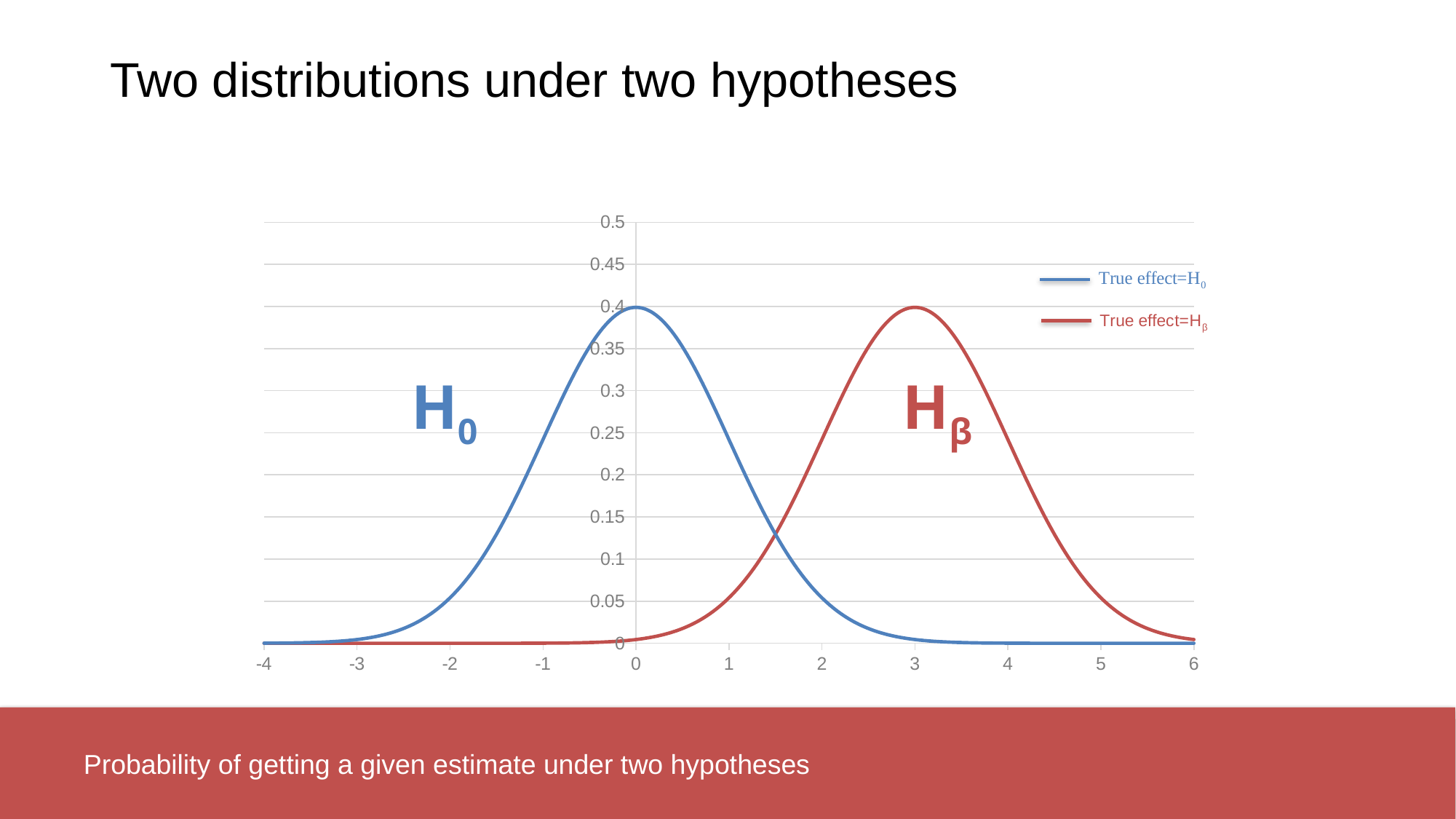
At x = 1, which curve is higher, the blue H0 curve or the red Hβ curve? blue H0 curve How many series does the chart's legend list? 2 At x = 2, which curve is higher, the blue H0 curve or the red Hβ curve? red Hβ curve Which colour is the curve labelled Hβ? red What is the peak value of the blue H0 curve? 0.4 At what x value does the red Hβ curve reach its peak? 3 Is the value of the blue H0 curve at x = 3 greater or less than 0.05? less What are the two legend entries in the chart? True effect=H0 and True effect=Hβ What kind of chart is shown on the slide? line chart Is the value of the red Hβ curve at x = 5 greater or less than 0.1? less Does the red Hβ curve rise or fall as x increases from 3 to 6? fall At what x value does the blue H0 curve reach its peak? 0